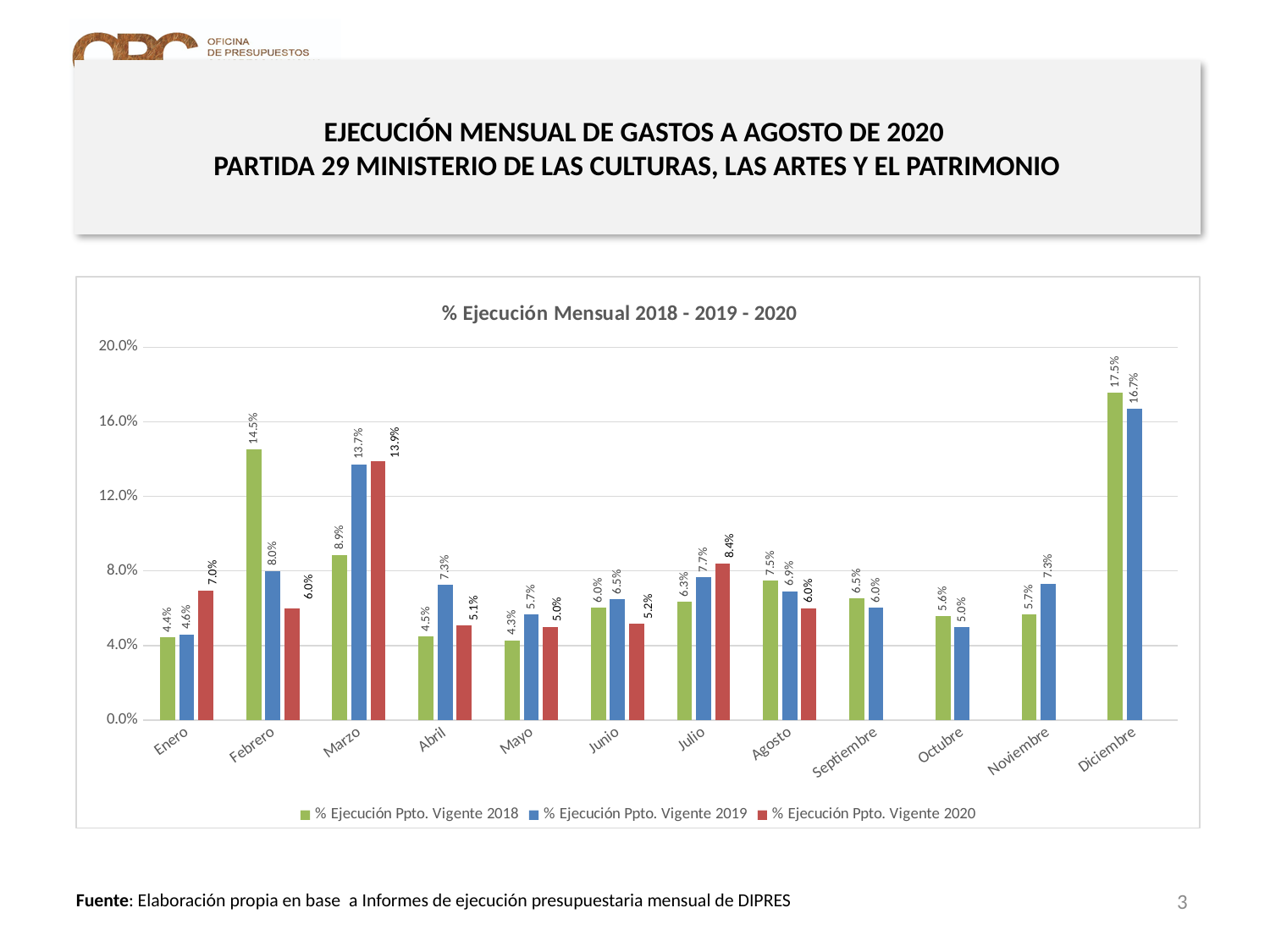
What is the value for % Ejecución Ppto. Vigente 2020 in Marzo? 13.9% What is the difference between the 2019 and 2018 values in Marzo? 4.8% What is the value for % Ejecución Ppto. Vigente 2019 in Diciembre? 16.7% In which month is the % Ejecución Ppto. Vigente 2018 series highest? Diciembre Which is larger in Julio: the 2019 value or the 2020 value? 2020 value (8.4%) What is the value for % Ejecución Ppto. Vigente 2018 in Febrero? 14.5% Is the value for % Ejecución Ppto. Vigente 2018 in Diciembre greater or less than 16.0%? greater How many months are shown on the x axis? 12 What is the title of the chart? % Ejecución Mensual 2018 - 2019 - 2020 In which month is the % Ejecución Ppto. Vigente 2020 series lowest? Mayo How many series does the legend list? 3 What kind of chart is shown? Bar chart